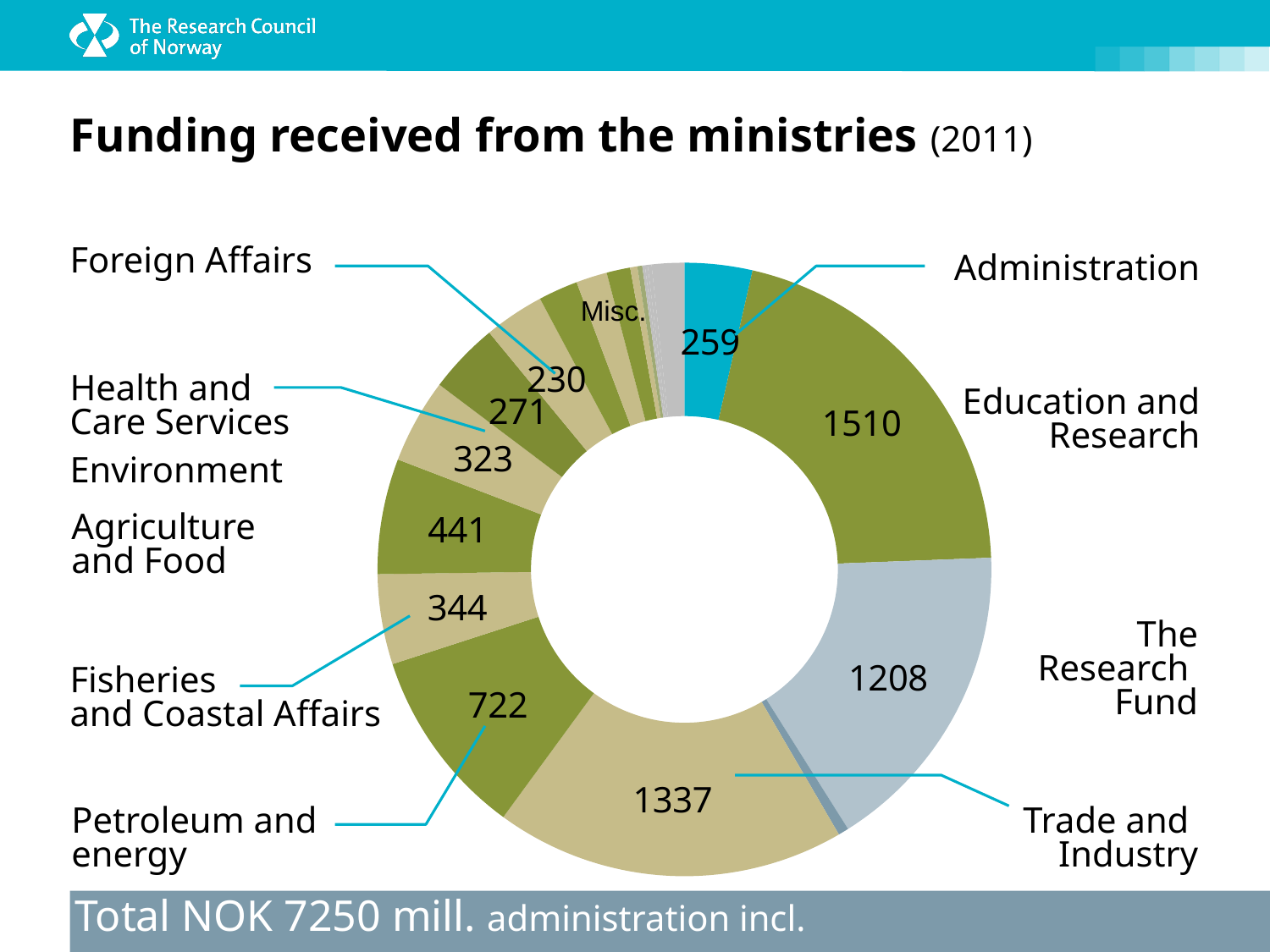
What is the funding value shown for Trade and Industry? 1337 What kind of chart is shown on the slide? Doughnut chart What is the funding value shown for Petroleum and energy? 722 What is the value shown for Administration? 259 What is the difference between the values for Trade and Industry and Petroleum and energy? 615 Among the ministries with a printed value, which has the lowest value? Foreign Affairs What is the funding value shown for Education and Research? 1510 Which has the larger value, Agriculture and Food or Fisheries and Coastal Affairs? Agriculture and Food What is the funding value shown for Environment? 323 Which ministry has the largest slice in the chart? Education and Research What is the difference between the values for Education and Research and The Research Fund? 302 What total funding amount is stated at the bottom of the slide? NOK 7250 mill.